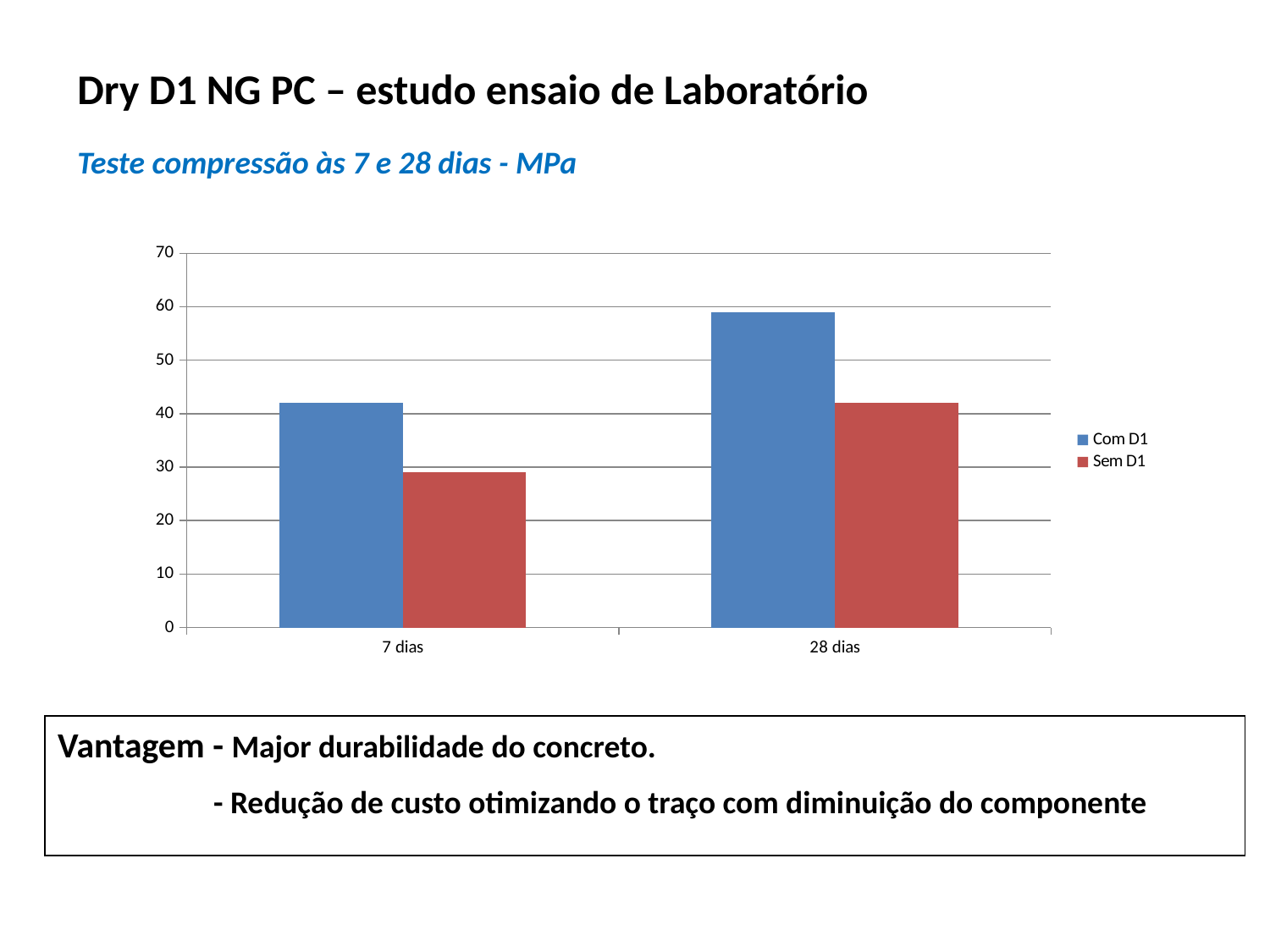
What kind of chart is shown on the slide? bar chart How many series does the legend list? 2 Is the value for Com D1 at 28 dias greater or less than 50? greater Is the value for Com D1 at 7 dias greater or less than 30? greater At 7 dias, which is larger: Com D1 or Sem D1? Com D1 Is the value for Sem D1 at 7 dias greater or less than 40? less What colour are the Sem D1 bars? red How many categories are shown on the x axis? 2 Which bar is the lowest in the chart? Sem D1 at 7 dias Do the Com D1 values rise or fall from 7 dias to 28 dias? rise Which series has the highest bar in the chart? Com D1 At 28 dias, which is larger: Com D1 or Sem D1? Com D1